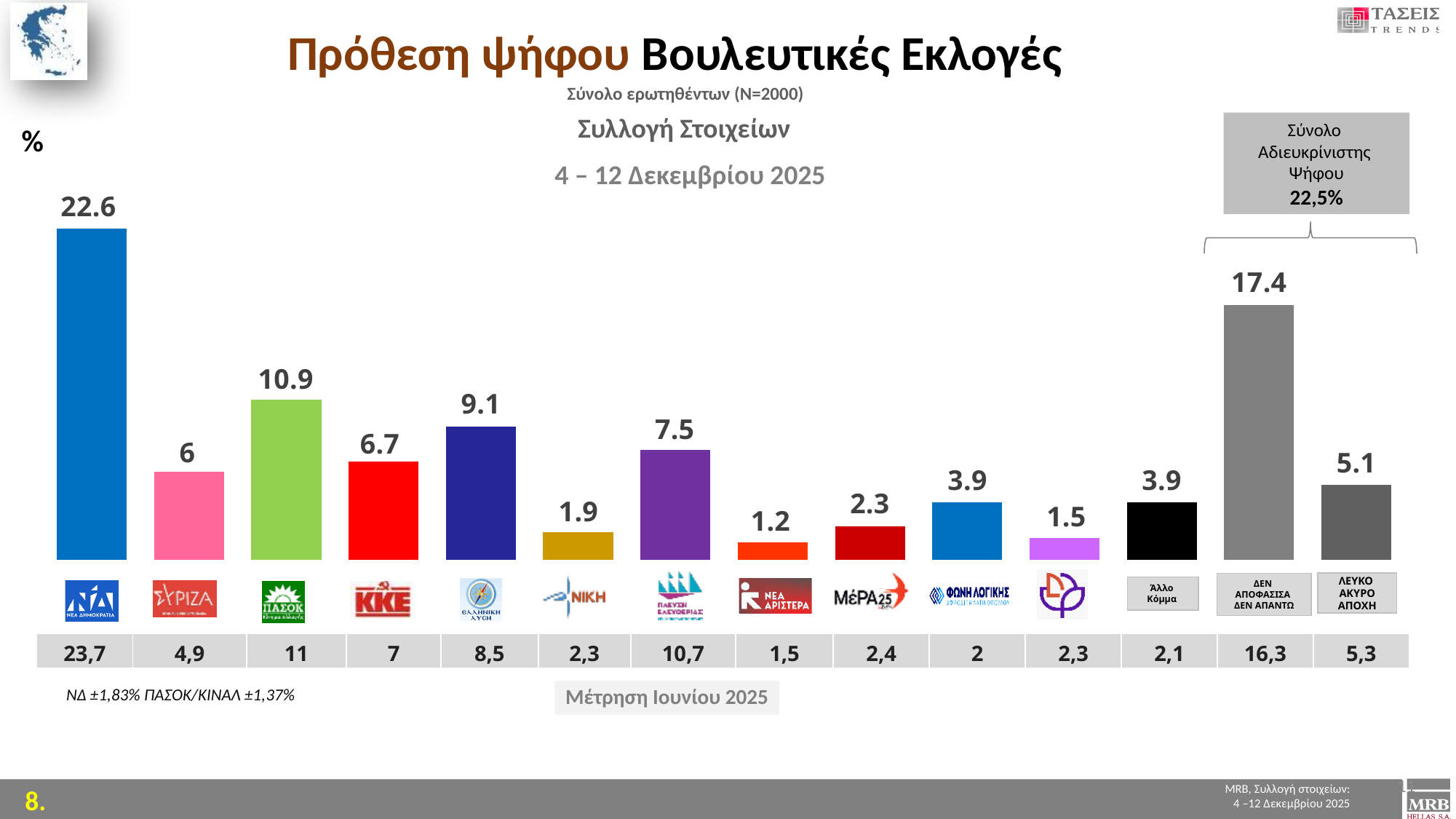
What is the value shown for 'ΛΕΥΚΟ ΑΚΥΡΟ ΑΠΟΧΗ' in the bar chart? 5.1 Which party has the highest value in the bar chart? ΝΔ (Νέα Δημοκρατία) What value is shown in the June 2025 row (Μέτρηση Ιουνίου 2025) for ΝΔ? 23,7 What percentage is given in the box labelled 'Σύνολο Αδιευκρίνιστης Ψήφου'? 22,5% Which has a larger value, ΚΚΕ or ΣΥΡΙΖΑ? ΚΚΕ What is the value shown for ΝΔ (Νέα Δημοκρατία) in the bar chart? 22.6 What is the difference between the values for ΝΔ and ΠΑΣΟΚ? 11.7 What is the value shown for ΠΑΣΟΚ in the bar chart? 10.9 What is the value shown for the 'ΔΕΝ ΑΠΟΦΑΣΙΣΑ ΔΕΝ ΑΠΑΝΤΩ' bar? 17.4 What type of chart is shown on the slide? bar chart Which bar has the lowest value in the chart? Νέα Αριστερά (1.2) How many bars are shown in the chart? 14